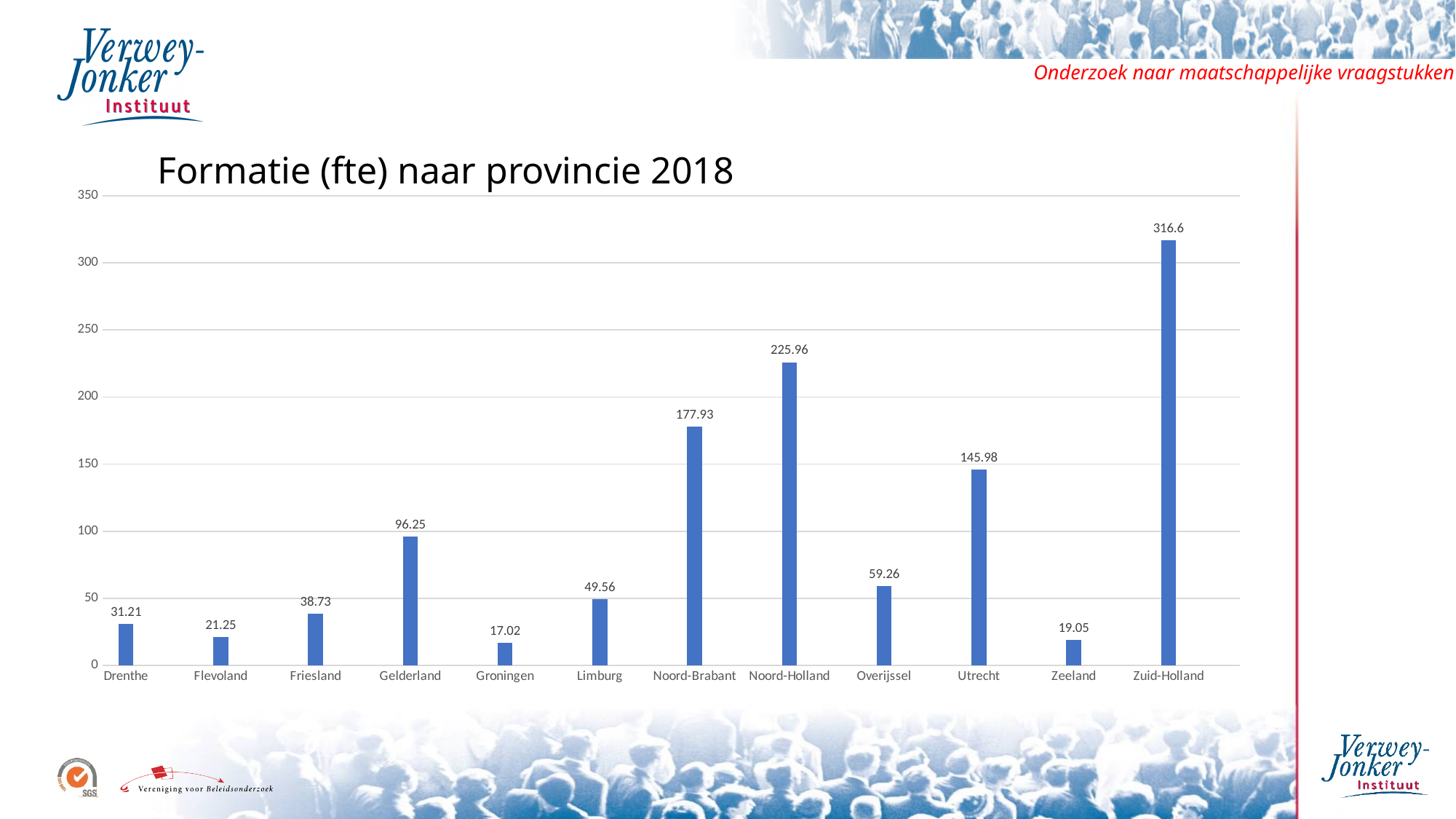
What is the value for Noord-Holland? 225.96 How many provinces are shown on the x axis? 12 What is the value for Zeeland? 19.05 What kind of chart is shown on the slide? bar chart What is the value for Gelderland? 96.25 What is the difference between the values for Zuid-Holland and Noord-Holland? 90.64 Which province has the lowest value? Groningen Which is larger, the value for Limburg or the value for Overijssel? Overijssel What is the difference between the values for Noord-Brabant and Utrecht? 31.95 Which province has the highest value? Zuid-Holland What is the title of the chart? Formatie (fte) naar provincie 2018 Is the value for Utrecht greater or less than 100? greater